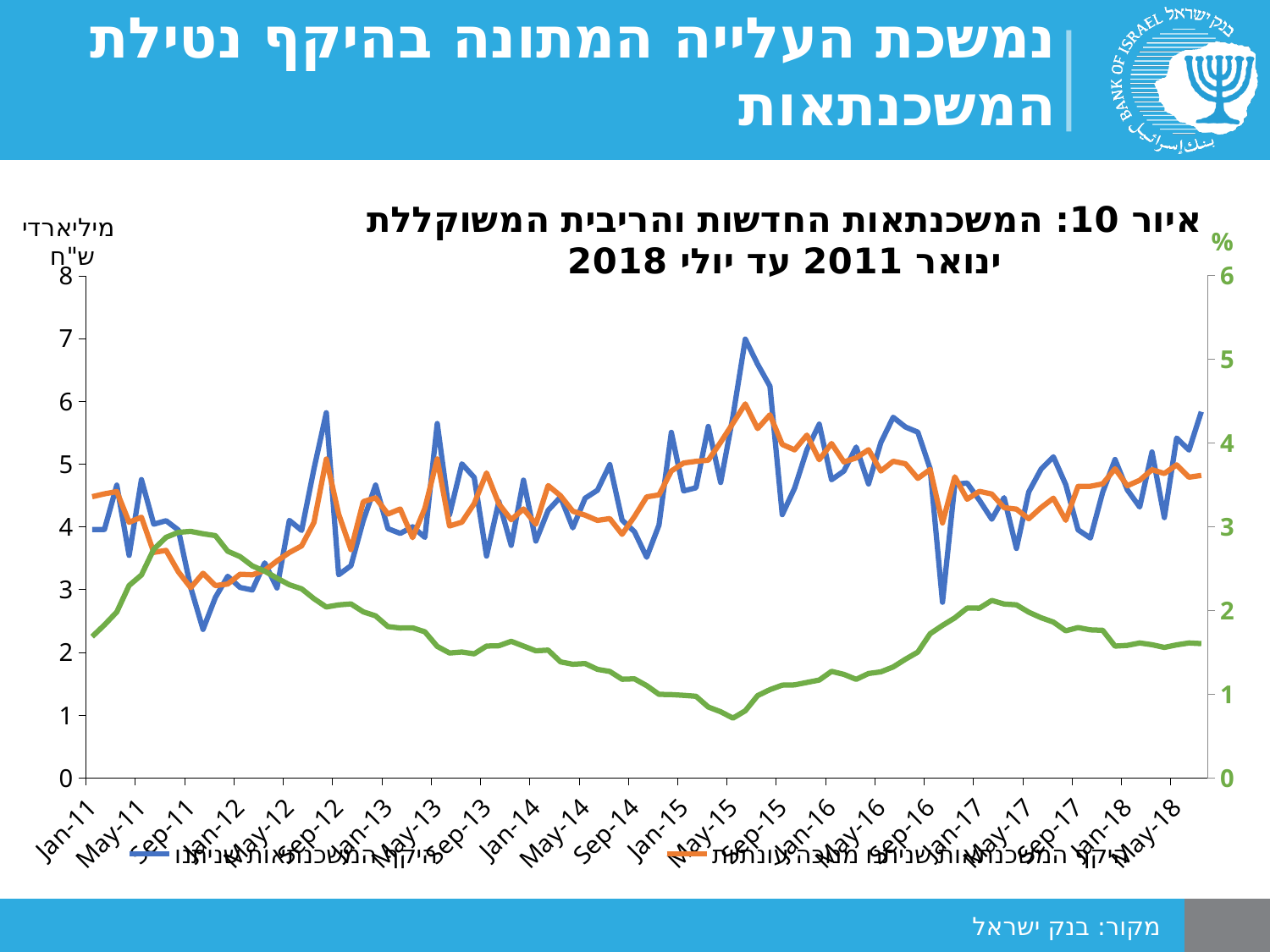
Is the lowest point of the green line, around May-15, greater or less than 2 on the left axis? less Is the value of the blue line at Jan-11 greater or less than 3 on the left axis? greater Which line is highest at May-15: blue, orange or green? blue What is the title of the chart? איור 10: המשכנתאות החדשות והריבית המשוקללת ינואר 2011 עד יולי 2018 What unit is shown on the left vertical axis of the chart? מיליארדי ש"ח What kind of chart is shown on the slide? line chart Which line is lowest at Jan-14: blue, orange or green? green Does the green line rise or fall between May-15 and Jan-17? rise At Jan-11, which line is higher: the blue line or the green line? blue How many lines are plotted on the chart? 3 Is the peak of the blue line, around May-15, greater or less than 6 on the left axis? greater Does the green line rise or fall between Sep-11 and May-15? fall